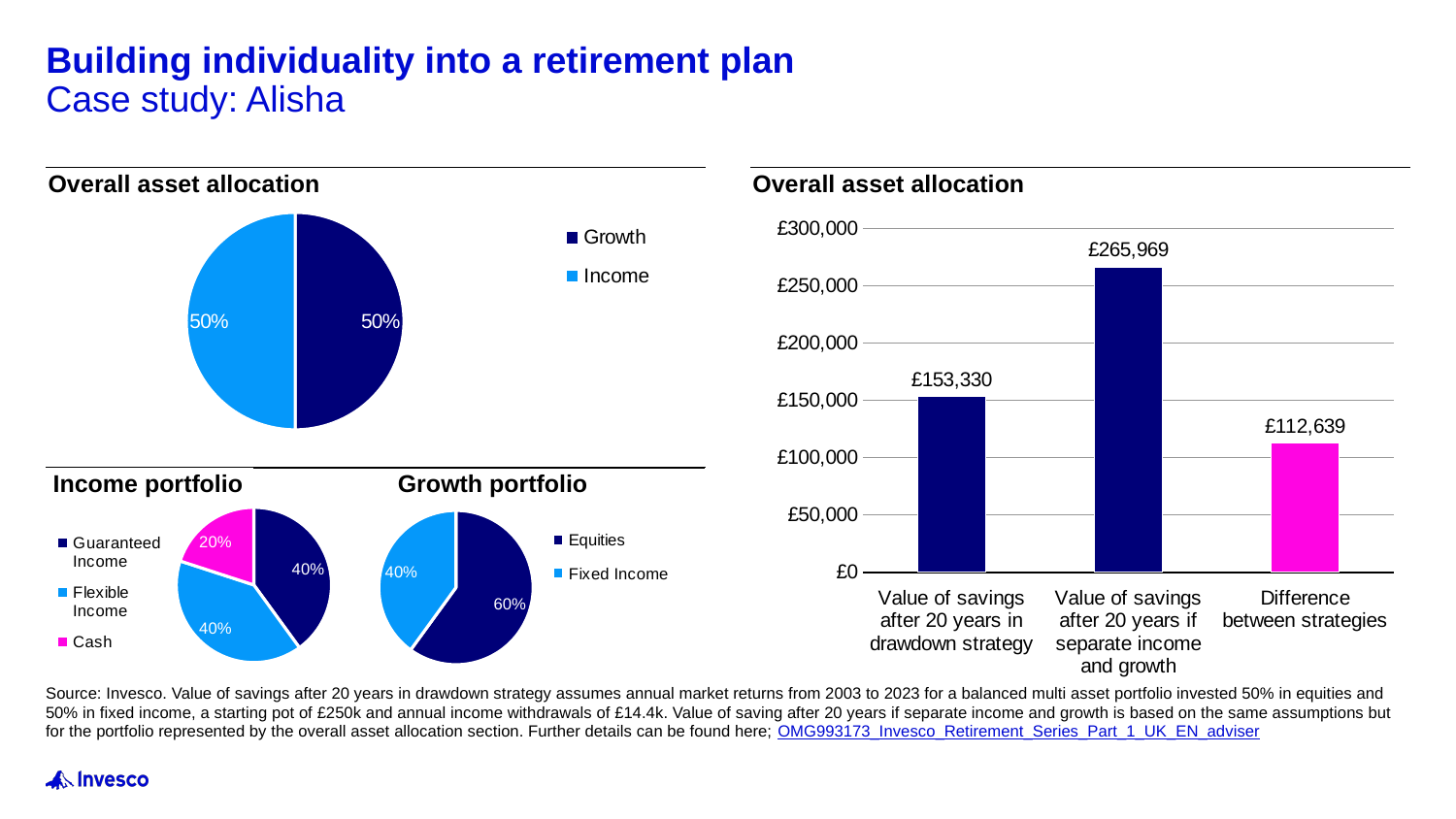
In the Income portfolio pie chart, what share is Guaranteed Income? 40% In the bar chart on the right, what is the value of savings after 20 years if separate income and growth? £265,969 In the bar chart on the right, is the value of savings after 20 years in drawdown strategy greater or less than £200,000? less In the Growth portfolio pie chart, what share is Equities? 60% In the bar chart on the right, what is the value of savings after 20 years in drawdown strategy? £153,330 In the bar chart on the right, what is the difference between strategies? £112,639 In the bar chart on the right, how many bars are plotted? 3 In the Overall asset allocation pie chart at the top left, what share is Growth? 50% In the bar chart on the right, which category has the highest value? Value of savings after 20 years if separate income and growth In the bar chart on the right, which category has the lowest value? Difference between strategies In the Growth portfolio pie chart, which slice is larger, Equities or Fixed Income? Equities